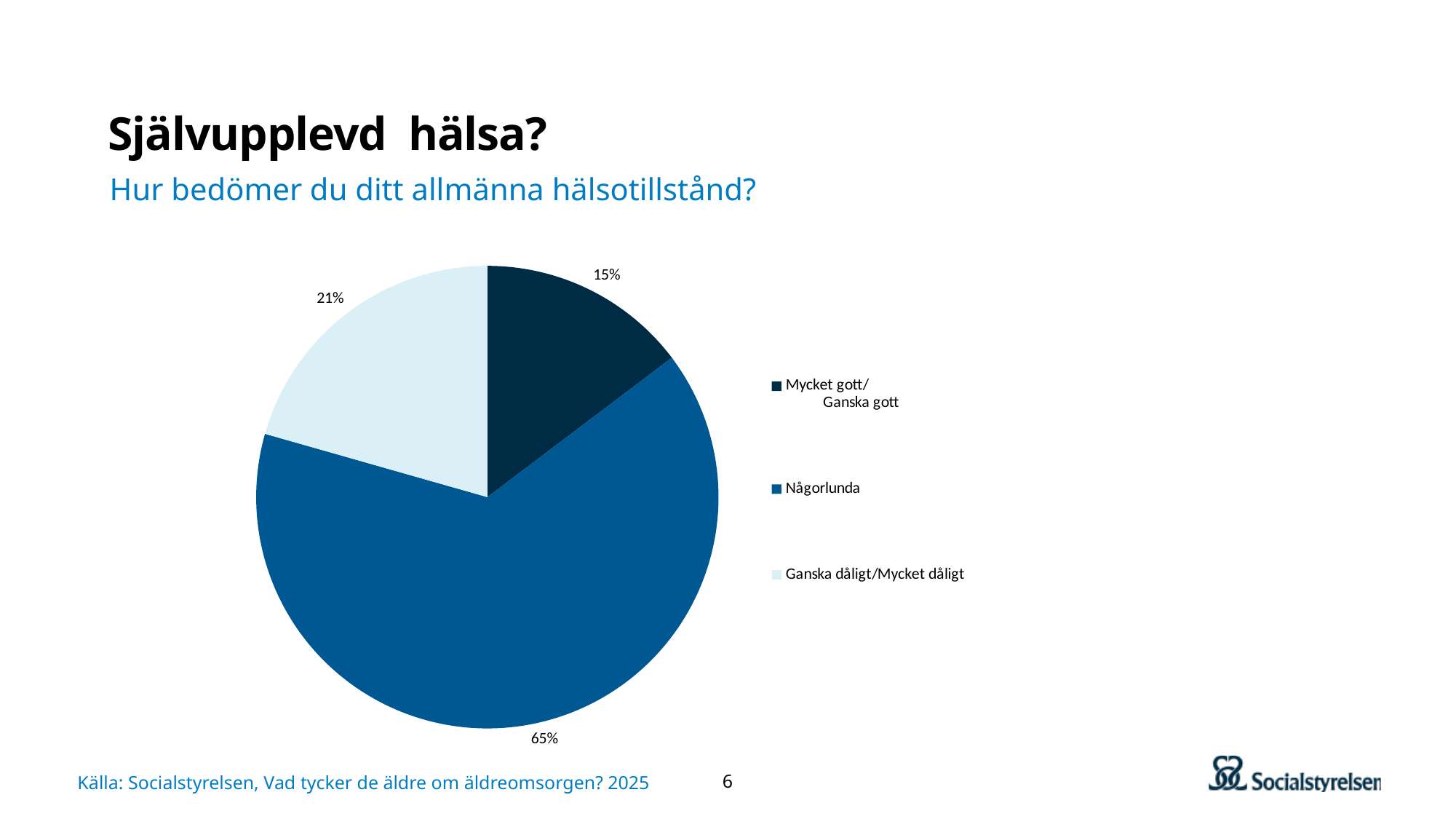
What is the difference in percentage points between the Någorlunda slice and the Ganska dåligt/Mycket dåligt slice? 44 What share of the pie is labelled Mycket gott/Ganska gott? 15% What share of the pie is labelled Någorlunda? 65% What share of the pie is labelled Ganska dåligt/Mycket dåligt? 21% How many slices does the pie chart have? 3 What is the source cited at the bottom of the slide? Socialstyrelsen, Vad tycker de äldre om äldreomsorgen? 2025 Which category has the largest slice of the pie? Någorlunda What kind of chart is shown on the slide? pie chart What question is the pie chart answering, according to the subtitle? Hur bedömer du ditt allmänna hälsotillstånd? Which category has the smallest slice of the pie? Mycket gott/Ganska gott How many entries does the legend list? 3 Which slice is larger: Ganska dåligt/Mycket dåligt or Mycket gott/Ganska gott? Ganska dåligt/Mycket dåligt